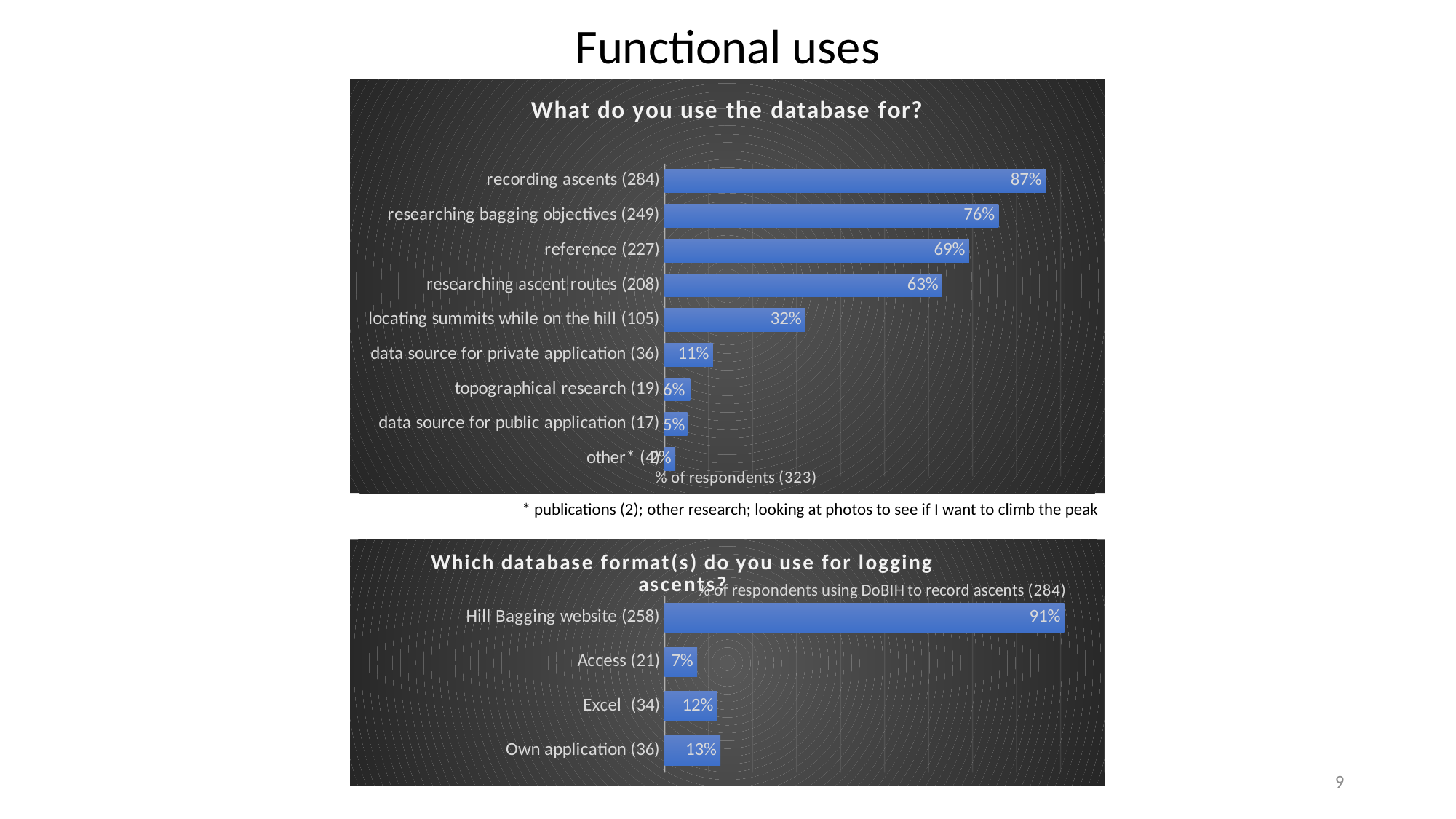
In the chart titled "What do you use the database for?", what percentage of respondents use the database for recording ascents? 87% What type of chart is the top chart, "What do you use the database for?"? bar chart In the chart titled "Which database format(s) do you use for logging ascents?", what percentage use the Hill Bagging website? 91% In the chart titled "What do you use the database for?", which is larger: researching ascent routes or data source for private application? researching ascent routes In the chart titled "Which database format(s) do you use for logging ascents?", what is the difference in percentage points between Own application and Excel? 1 How many categories are shown in the chart titled "What do you use the database for?"? 9 In the chart titled "What do you use the database for?", which category has the highest percentage? recording ascents (284) How many categories are shown in the chart titled "Which database format(s) do you use for logging ascents?"? 4 In the chart titled "What do you use the database for?", what is the value for locating summits while on the hill? 32% In the chart titled "Which database format(s) do you use for logging ascents?", which format has the lowest percentage? Access (21) In the chart titled "Which database format(s) do you use for logging ascents?", what is the axis label shown above the bars? % of respondents using DoBIH to record ascents (284) In the chart titled "What do you use the database for?", what is the difference in percentage points between researching bagging objectives and reference? 7